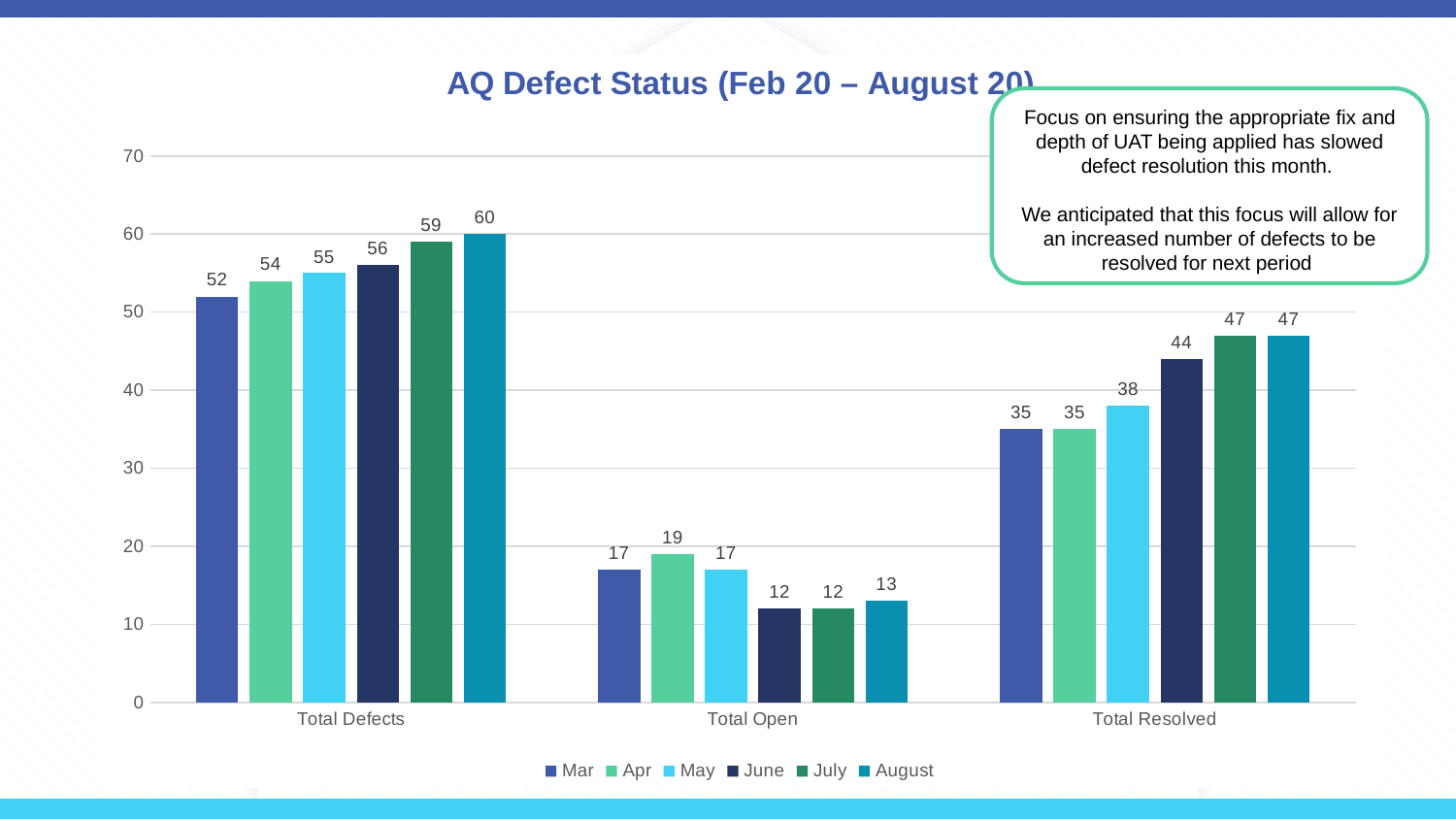
What is the value for June in the Total Resolved category? 44 What kind of chart is shown on the slide? Bar chart Which is larger: the May value for Total Open or the July value for Total Open? May What is the value for Apr in the Total Open category? 19 How many series does the legend list? 6 Which month has the highest value in the Total Open category? Apr How many categories are shown on the x axis? 3 What is the difference between the August and Mar values in the Total Resolved category? 12 Which month has the lowest value in the Total Defects category? Mar What is the title of the chart? AQ Defect Status (Feb 20 – August 20) What is the value for August in the Total Defects category? 60 Do the Total Defects values rise or fall from Mar to August? Rise